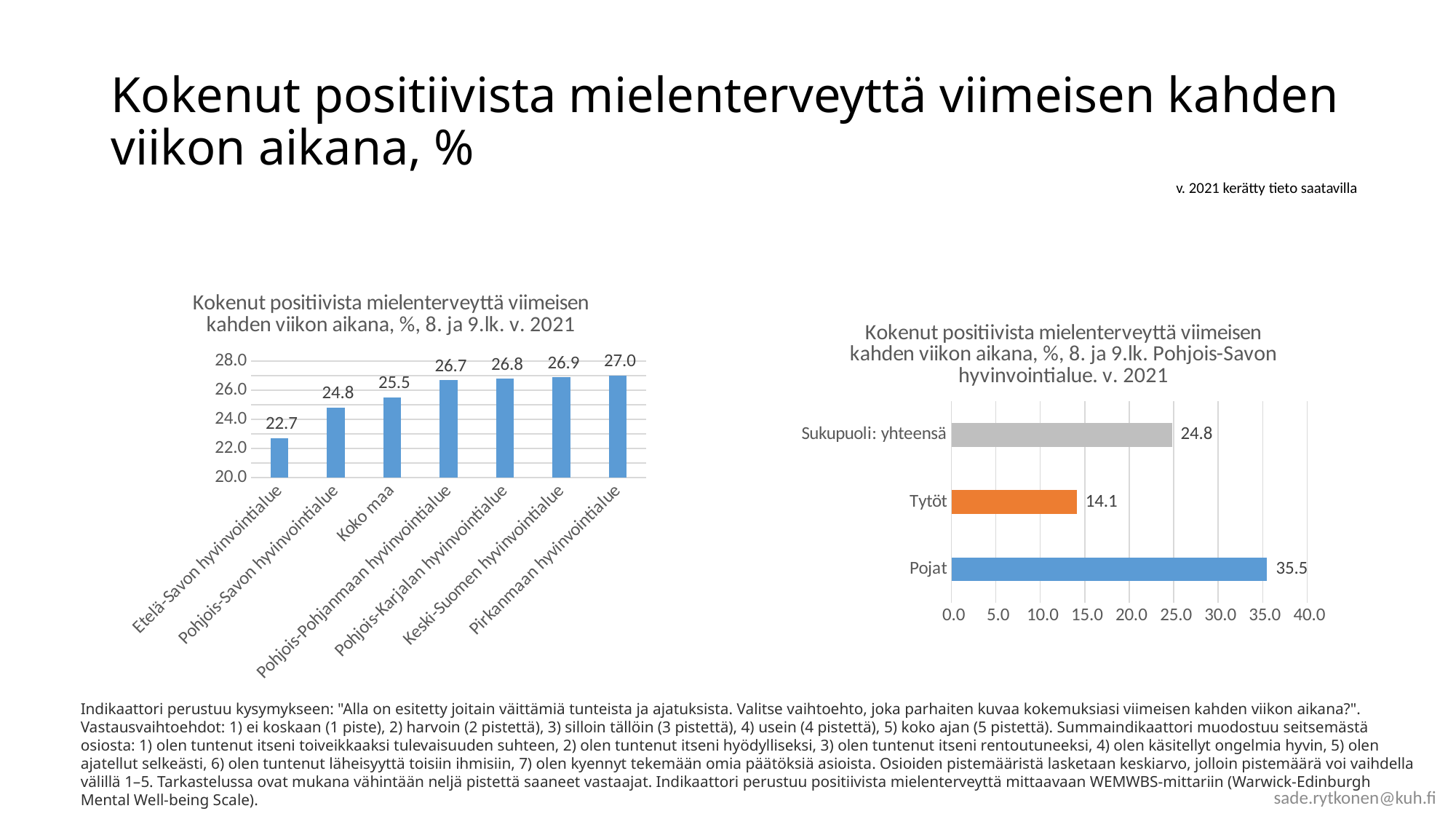
What kind of chart is the right chart (Pohjois-Savon hyvinvointialue)? bar chart In the left chart (8. ja 9.lk. v. 2021), which category has the highest value? Pirkanmaan hyvinvointialue In the right chart (Pohjois-Savon hyvinvointialue), which is larger, Tytöt or Sukupuoli: yhteensä? Sukupuoli: yhteensä In the left chart (8. ja 9.lk. v. 2021), how many categories are shown? 7 In the right chart (Pohjois-Savon hyvinvointialue), what is the difference between Pojat and Tytöt? 21.4 In the right chart (Pohjois-Savon hyvinvointialue), what is the value for Pojat? 35.5 In the left chart (8. ja 9.lk. v. 2021), do the values rise or fall from left to right? rise In the right chart (Pohjois-Savon hyvinvointialue), what is the value for Tytöt? 14.1 In the left chart (8. ja 9.lk. v. 2021), what is the value for Koko maa? 25.5 In the left chart (8. ja 9.lk. v. 2021), what is the difference between Pirkanmaan hyvinvointialue and Etelä-Savon hyvinvointialue? 4.3 In the left chart (8. ja 9.lk. v. 2021), which category has the lowest value? Etelä-Savon hyvinvointialue In the left chart (8. ja 9.lk. v. 2021), what is the value for Pohjois-Savon hyvinvointialue? 24.8